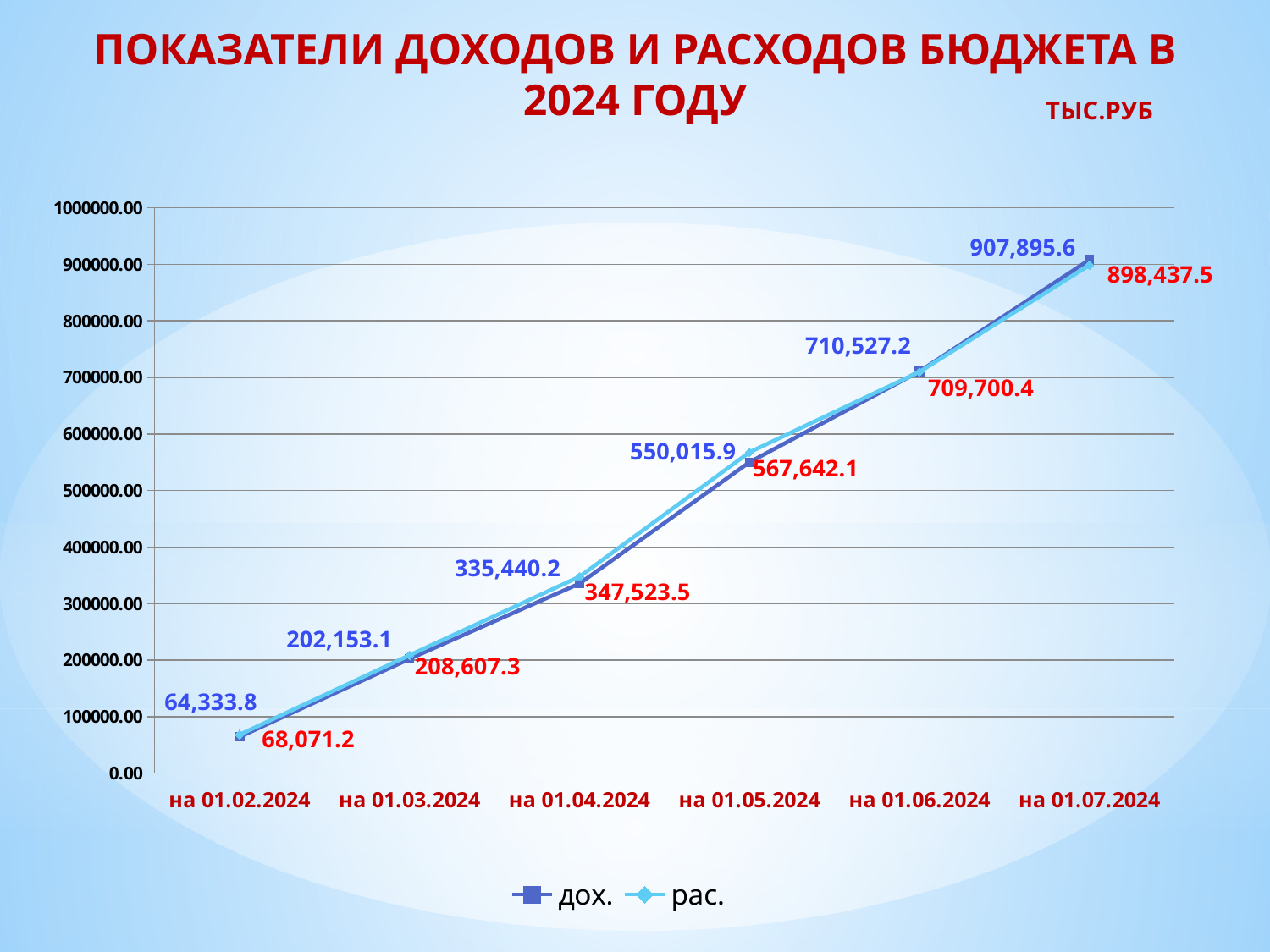
What type of chart is shown on the slide? line chart What is the value of дох. на 01.02.2024? 64,333.8 On which date is the value of дох. the highest? на 01.07.2024 What is the value of рас. на 01.04.2024? 347,523.5 What is the value of дох. на 01.07.2024? 907,895.6 Do the values of дох. rise or fall from 01.02.2024 to 01.07.2024? rise How many dates are plotted along the x axis? 6 What is the value of рас. на 01.06.2024? 709,700.4 How many series does the legend list? 2 What is the difference between дох. and рас. на 01.07.2024? 9,458.1 On which date is the value of рас. the lowest? на 01.02.2024 Which is larger на 01.05.2024, дох. or рас.? рас.